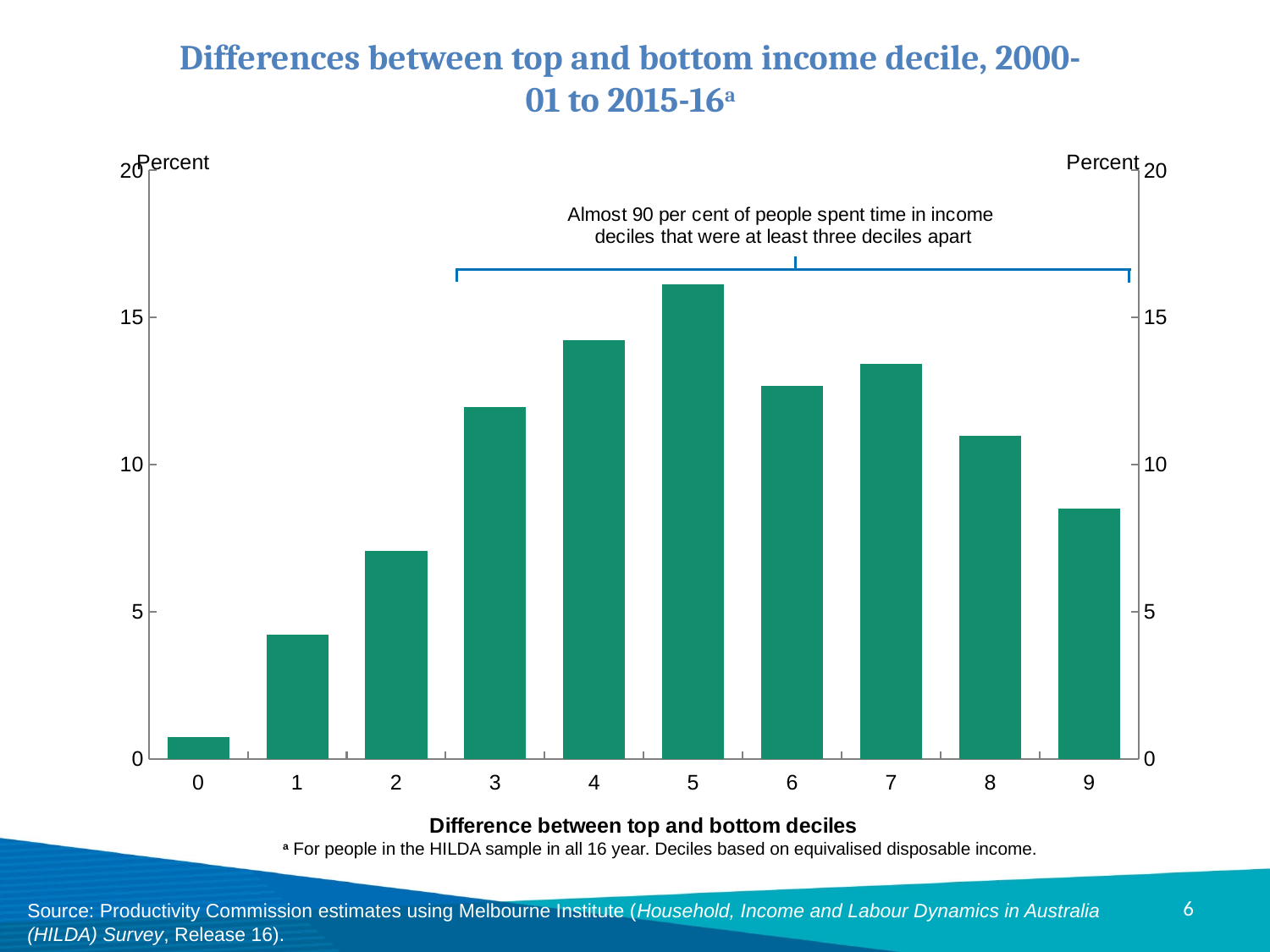
Is the value for a difference of 5 greater or less than 15? greater Is the value for a difference of 9 greater or less than 10? less What kind of chart is shown on the slide? bar chart Is the value for a difference of 1 greater or less than 5? less What is the label of the x axis of the chart? Difference between top and bottom deciles Which difference between top and bottom deciles has the highest percentage? 5 Which difference between top and bottom deciles has the lowest percentage? 0 Which is larger, the value for a difference of 2 or the value for a difference of 9? 9 How many categories are shown on the x axis of the chart? 10 Do the values rise or fall as the difference increases from 0 to 5? rise Which is larger, the value for a difference of 4 or the value for a difference of 6? 4